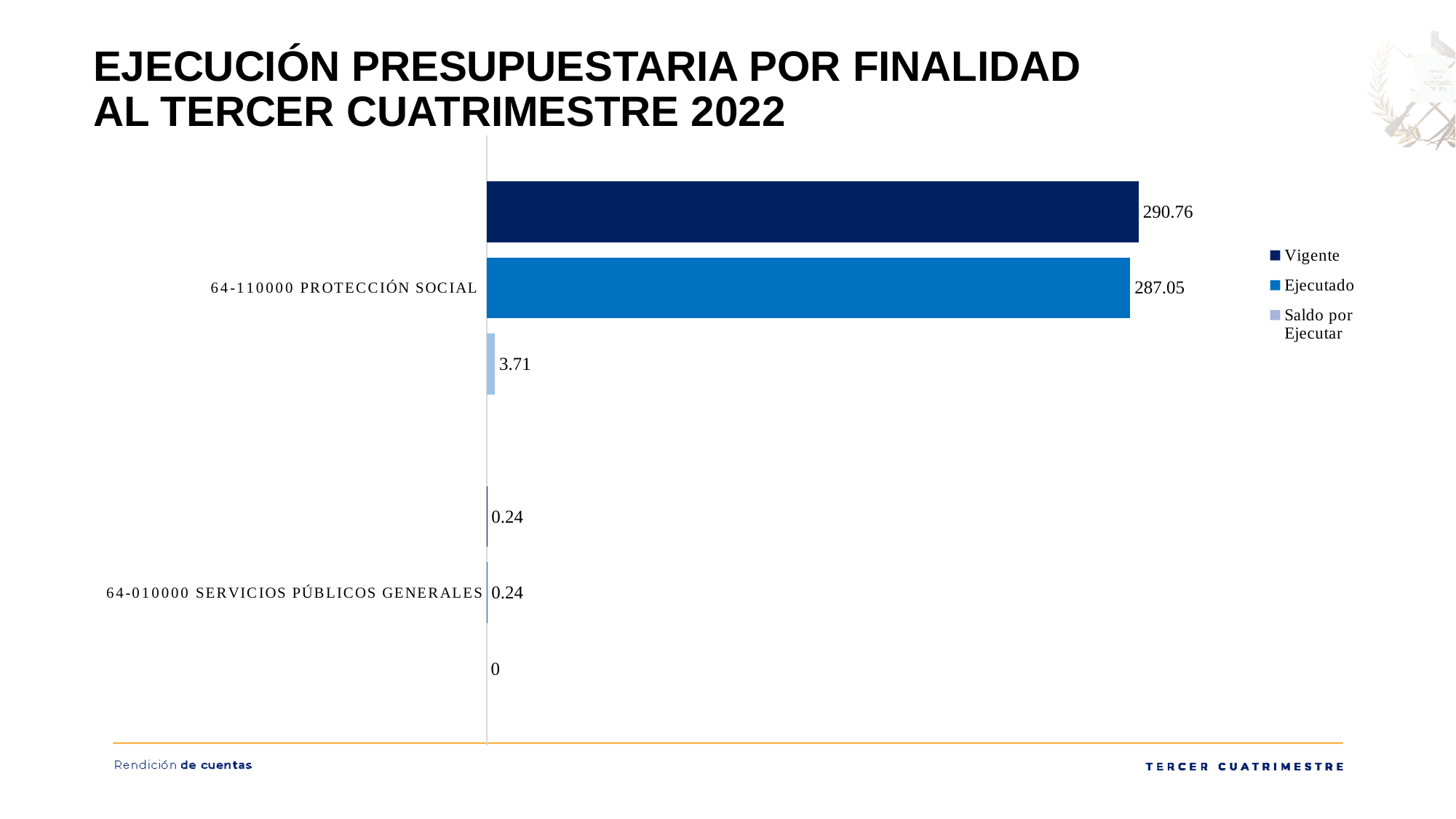
What is the Vigente value for 64-010000 SERVICIOS PÚBLICOS GENERALES? 0.24 How many categories are shown on the chart? 2 Which category has the highest Vigente value? 64-110000 PROTECCIÓN SOCIAL What is the Ejecutado value for 64-110000 PROTECCIÓN SOCIAL? 287.05 Which is larger for 64-110000 PROTECCIÓN SOCIAL, the Vigente value or the Ejecutado value? Vigente What is the Saldo por Ejecutar value for 64-010000 SERVICIOS PÚBLICOS GENERALES? 0 How many series does the legend list? 3 What kind of chart is shown on the slide? Bar chart What is the Saldo por Ejecutar value for 64-110000 PROTECCIÓN SOCIAL? 3.71 What is the difference between the Vigente and Ejecutado values for 64-110000 PROTECCIÓN SOCIAL? 3.71 What is the Vigente value for 64-110000 PROTECCIÓN SOCIAL? 290.76 Which category has the lowest Ejecutado value? 64-010000 SERVICIOS PÚBLICOS GENERALES